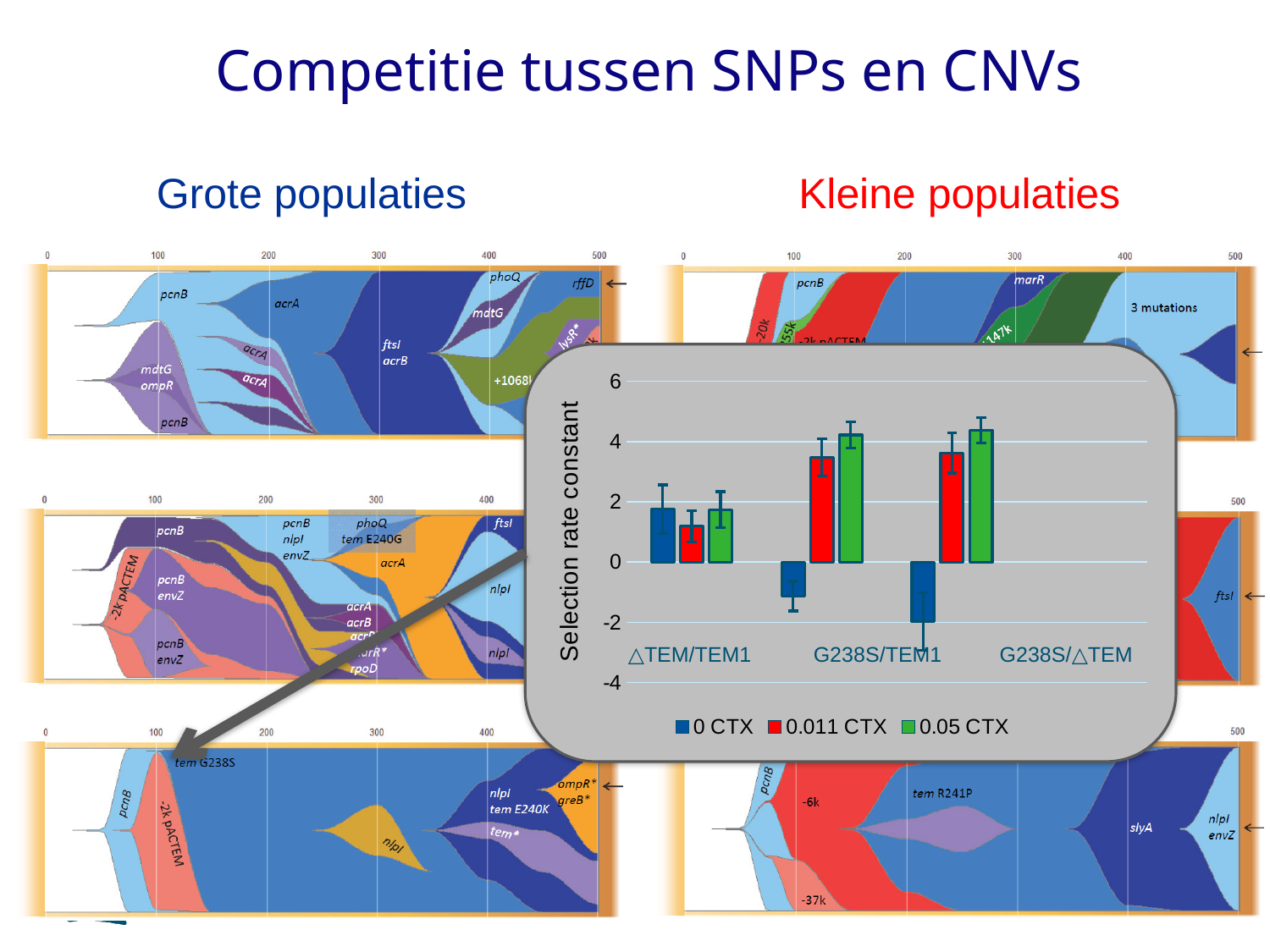
In the bar chart, is the 0.011 CTX value for G238S/TEM1 greater or less than 2? greater What is the y-axis title of the bar chart? Selection rate constant In the bar chart, is the 0.05 CTX value for G238S/△TEM greater or less than 2? greater How many series does the legend of the bar chart list? 3 In the bar chart, which is larger for G238S/TEM1: the 0 CTX value or the 0.05 CTX value? 0.05 CTX How many categories are shown on the x axis of the bar chart? 3 Which colour represents the 0.011 CTX series in the bar chart? red What kind of chart is shown in the grey overlay box on the slide? bar chart In the bar chart, is the 0 CTX value for G238S/△TEM greater or less than 0? less In the bar chart, do the 0 CTX values rise or fall from △TEM/TEM1 to G238S/△TEM? fall In the bar chart, which category has the lowest 0 CTX value? G238S/△TEM